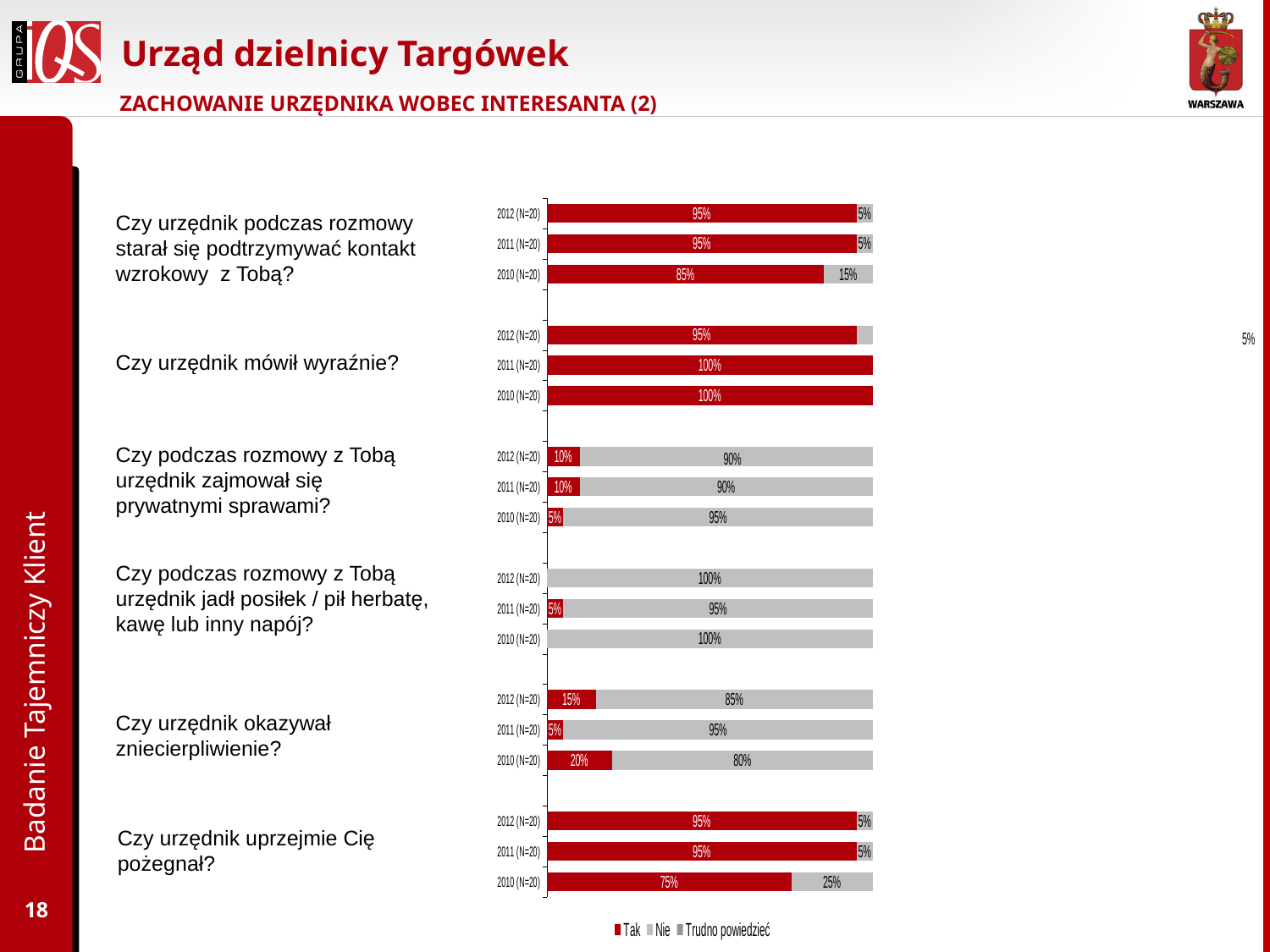
For "Czy podczas rozmowy z Tobą urzędnik zajmował się prywatnymi sprawami?", which year had the lowest "Tak" share? 2010 (N=20) For "Czy urzędnik uprzejmie Cię pożegnał?", is the "Nie" share in 2010 (N=20) larger or smaller than in 2012 (N=20)? larger What share answered "Nie" in 2012 (N=20) to "Czy podczas rozmowy z Tobą urzędnik jadł posiłek / pił herbatę, kawę lub inny napój?"? 100% What share answered "Tak" in 2010 (N=20) to "Czy urzędnik okazywał zniecierpliwienie?"? 20% What share of respondents answered "Tak" in 2012 (N=20) to the question "Czy urzędnik podczas rozmowy starał się podtrzymywać kontakt wzrokowy z Tobą?"? 95% What share answered "Tak" in 2011 (N=20) to "Czy urzędnik mówił wyraźnie?"? 100% Which answer category is shown in red in the chart legend? Tak How many series does the chart legend list? 3 For "Czy urzędnik uprzejmie Cię pożegnał?", what is the difference between the "Tak" share in 2012 (N=20) and in 2010 (N=20)? 20% What share answered "Nie" in 2010 (N=20) to "Czy urzędnik podczas rozmowy starał się podtrzymywać kontakt wzrokowy z Tobą?"? 15% What type of chart is shown on the slide? stacked bar chart For "Czy urzędnik okazywał zniecierpliwienie?", which year had the highest "Tak" share: 2012, 2011 or 2010? 2010 (N=20)